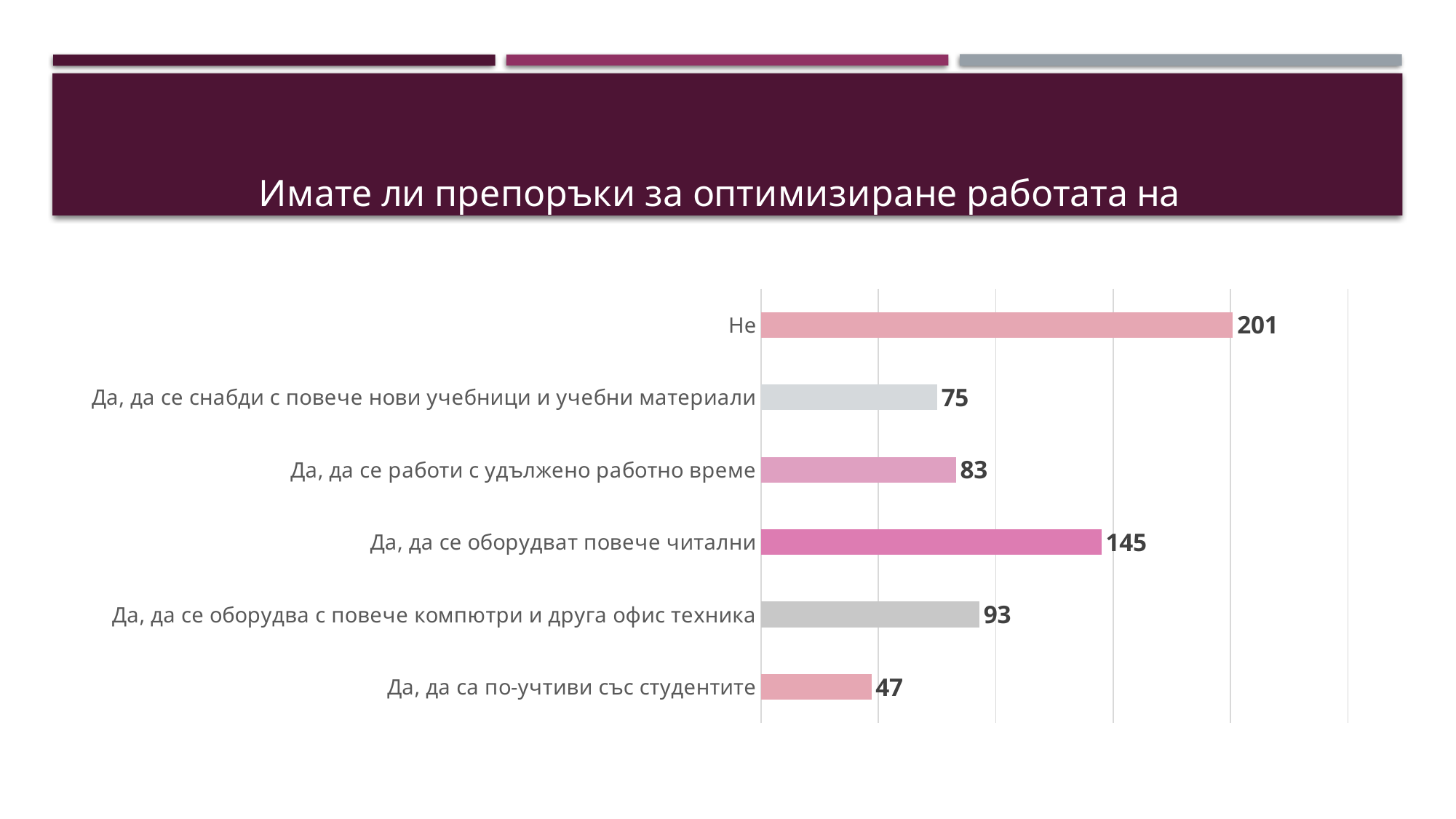
What is the difference between the values for "Не" and "Да, да се оборудват повече читални"? 56 What is the value for "Не"? 201 What is the title of the slide? Имате ли препоръки за оптимизиране работата на Which is larger: the value for "Да, да се работи с удължено работно време" or for "Да, да се снабди с повече нови учебници и учебни материали"? Да, да се работи с удължено работно време How many categories are shown in the chart? 6 What is the value for "Да, да се оборудват повече читални"? 145 What is the difference between the values for "Да, да се оборудва с повече компютри и друга офис техника" and "Да, да се работи с удължено работно време"? 10 What kind of chart is shown on the slide? Bar chart Which category has the lowest value? Да, да са по-учтиви със студентите Which category has the highest value? Не What is the value for "Да, да се оборудва с повече компютри и друга офис техника"? 93 What is the value for "Да, да са по-учтиви със студентите"? 47